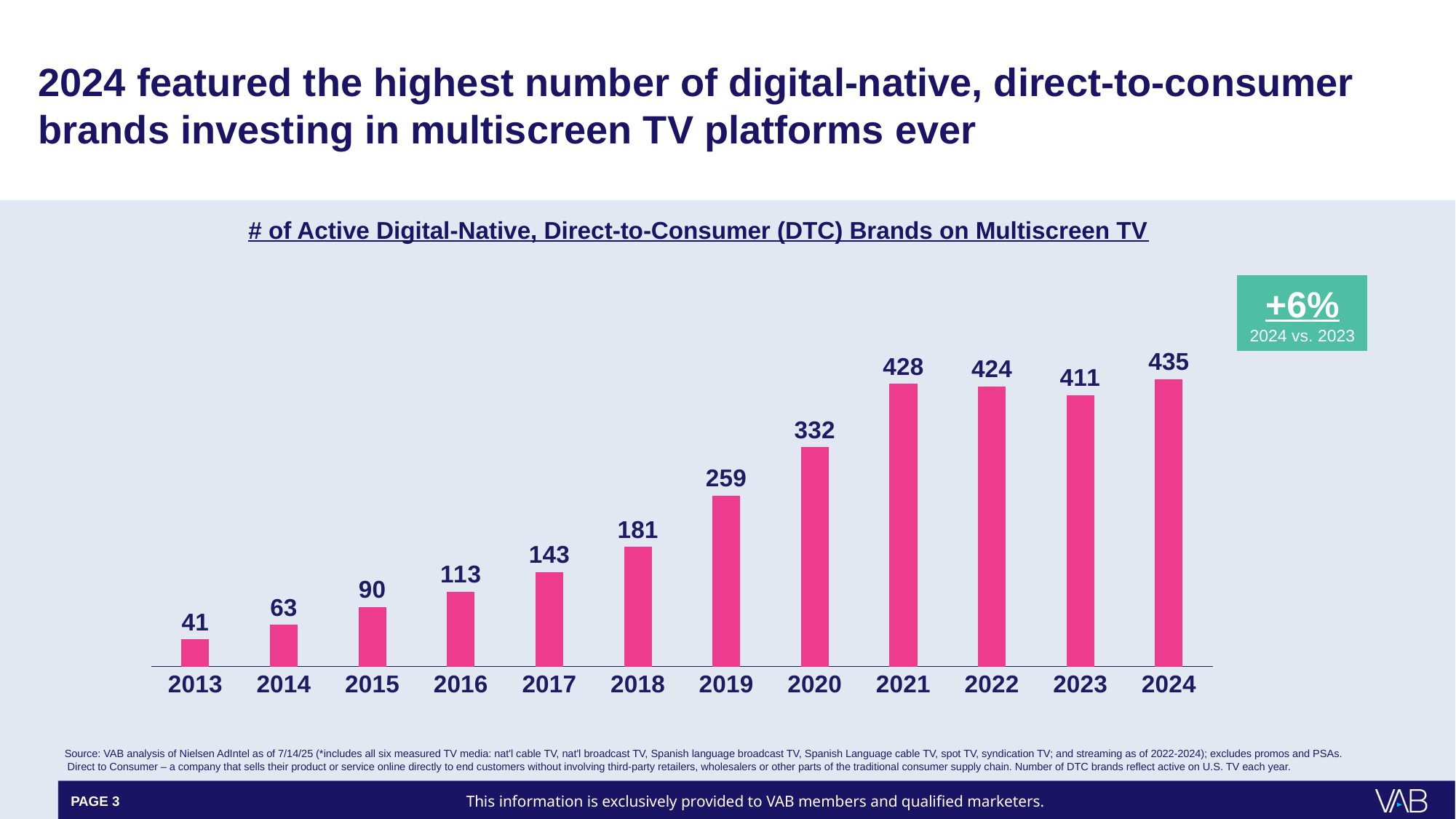
What is the value shown for 2013? 41 What is the difference between the values for 2024 and 2023? 24 What percentage change from 2023 to 2024 is highlighted in the green box? +6% What is the number of active DTC brands on multiscreen TV in 2020? 332 Which is larger, the value for 2021 or the value for 2022? 2021 Do the values generally rise or fall from 2013 to 2021? Rise Which year has the highest number of active DTC brands? 2024 What kind of chart is shown on the slide? Bar chart Which year has the lowest number of active DTC brands? 2013 What is the value shown for 2017? 143 How many years are shown on the x axis of the chart? 12 What is the difference between the values for 2021 and 2020? 96